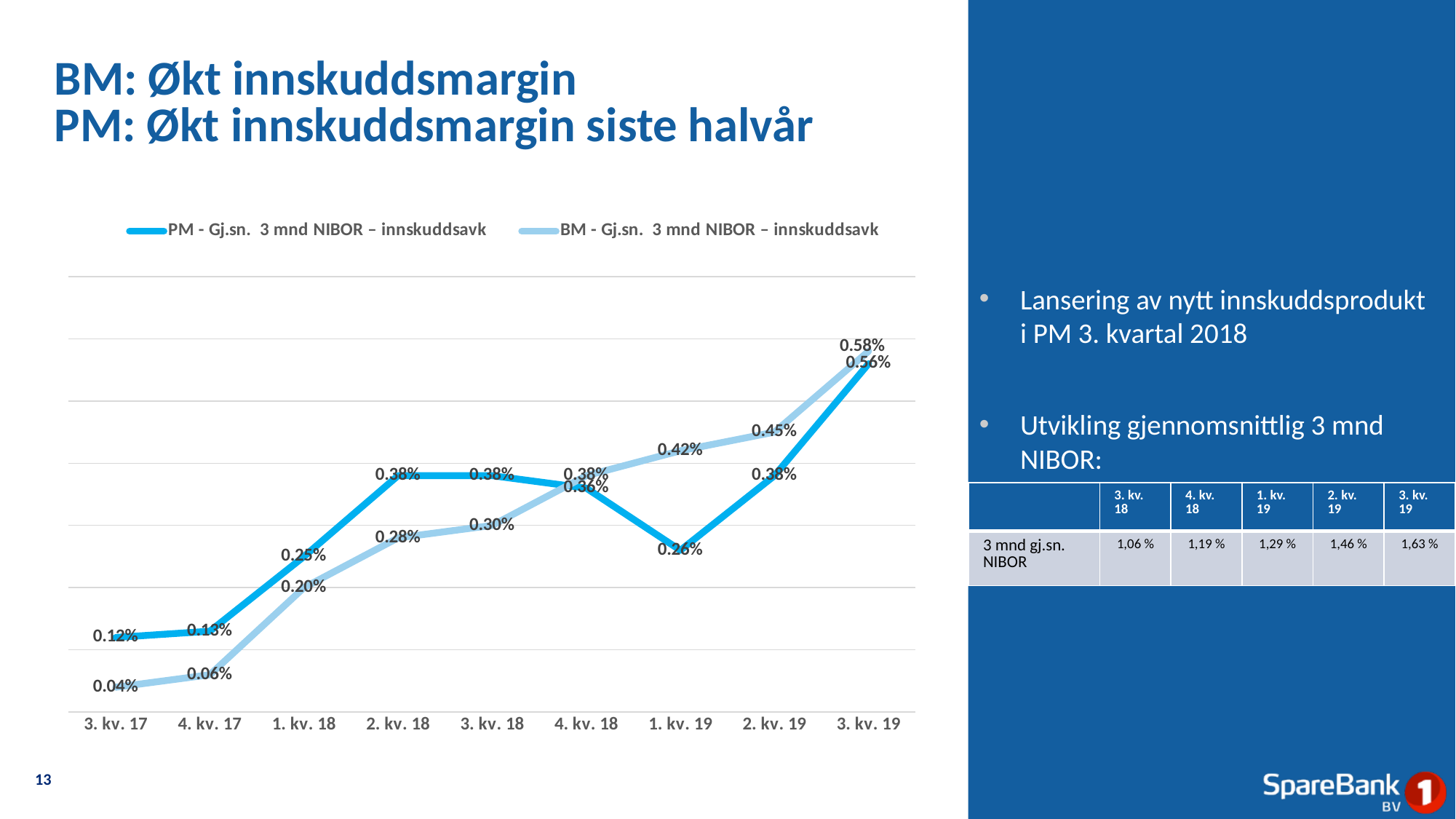
What is the difference between the BM and PM values at 3. kv. 19? 0.02% What kind of chart is shown on the slide? Line chart Does the BM series rise or fall from 3. kv. 17 to 3. kv. 19? Rise At 2. kv. 19, which series has the higher value, PM or BM? BM What is the value of the BM series at 3. kv. 17? 0.04% In which quarter is the PM series at its lowest value? 3. kv. 17 What is the value of the PM series at 1. kv. 19? 0.26% How many series does the legend list? 2 What is the value of the PM series at 3. kv. 17? 0.12% In which quarter does the BM series reach its highest value? 3. kv. 19 How many quarters are plotted along the x axis? 9 What is the value of the BM series at 1. kv. 19? 0.42%